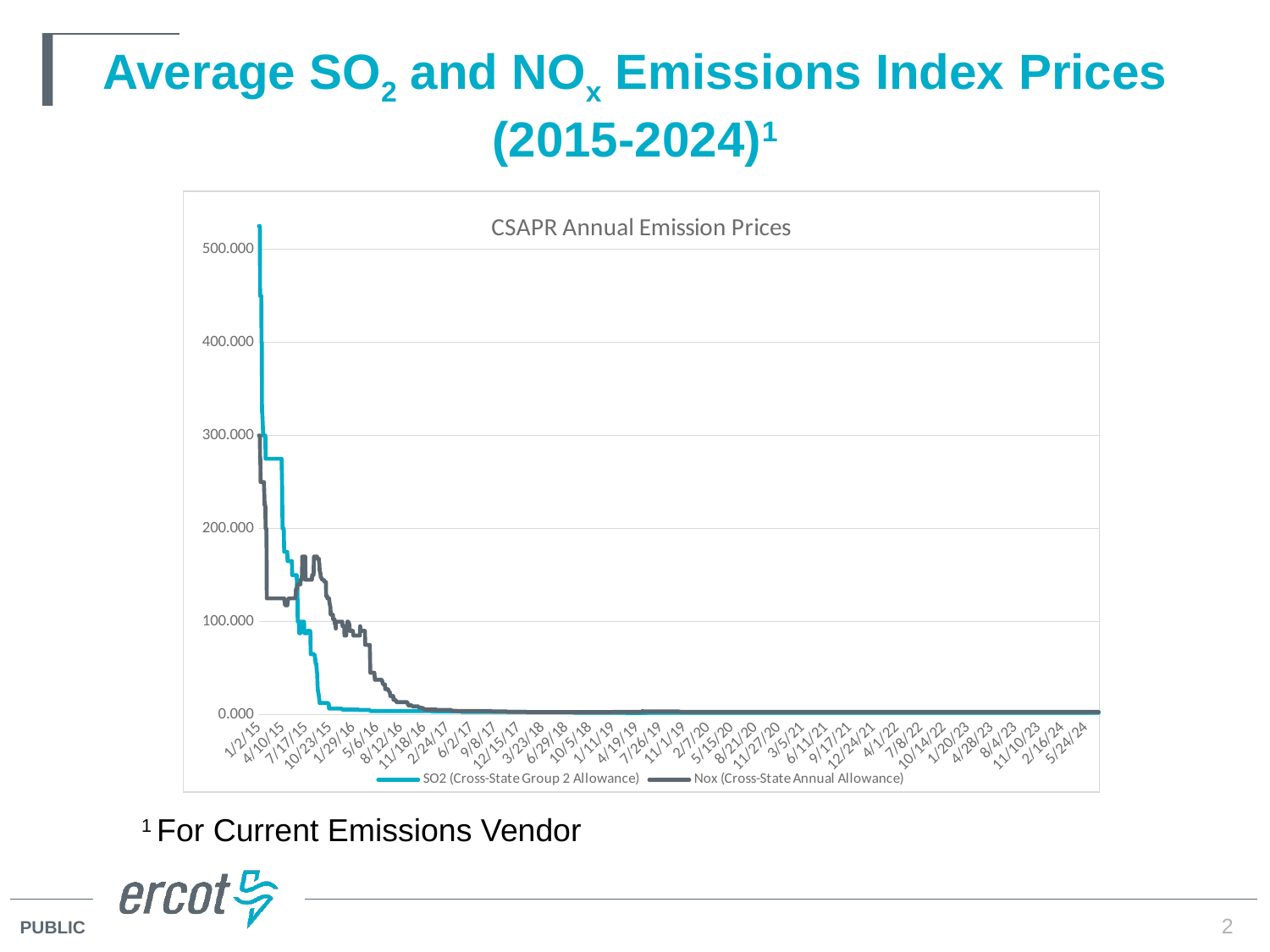
Do the SO2 (Cross-State Group 2 Allowance) values rise or fall over time along the x axis? fall Which series is drawn in teal (light blue) in the chart? SO2 (Cross-State Group 2 Allowance) How many series does the legend of the chart list? 2 What is the title printed inside the chart area? CSAPR Annual Emission Prices Around 1/29/16, which series has the higher value, SO2 (Cross-State Group 2 Allowance) or Nox (Cross-State Annual Allowance)? Nox (Cross-State Annual Allowance) At the start of the chart (1/2/15), is the SO2 (Cross-State Group 2 Allowance) value greater or less than 400.000? greater What kind of chart is shown on the slide? line chart Do the Nox (Cross-State Annual Allowance) values rise or fall over time along the x axis? fall At the end of the chart (5/24/24), is the Nox (Cross-State Annual Allowance) value greater or less than 100.000? less At the start of the chart (1/2/15), is the Nox (Cross-State Annual Allowance) value greater or less than 200.000? greater At the start of the chart in early 2015, which series has the higher value, SO2 (Cross-State Group 2 Allowance) or Nox (Cross-State Annual Allowance)? SO2 (Cross-State Group 2 Allowance)